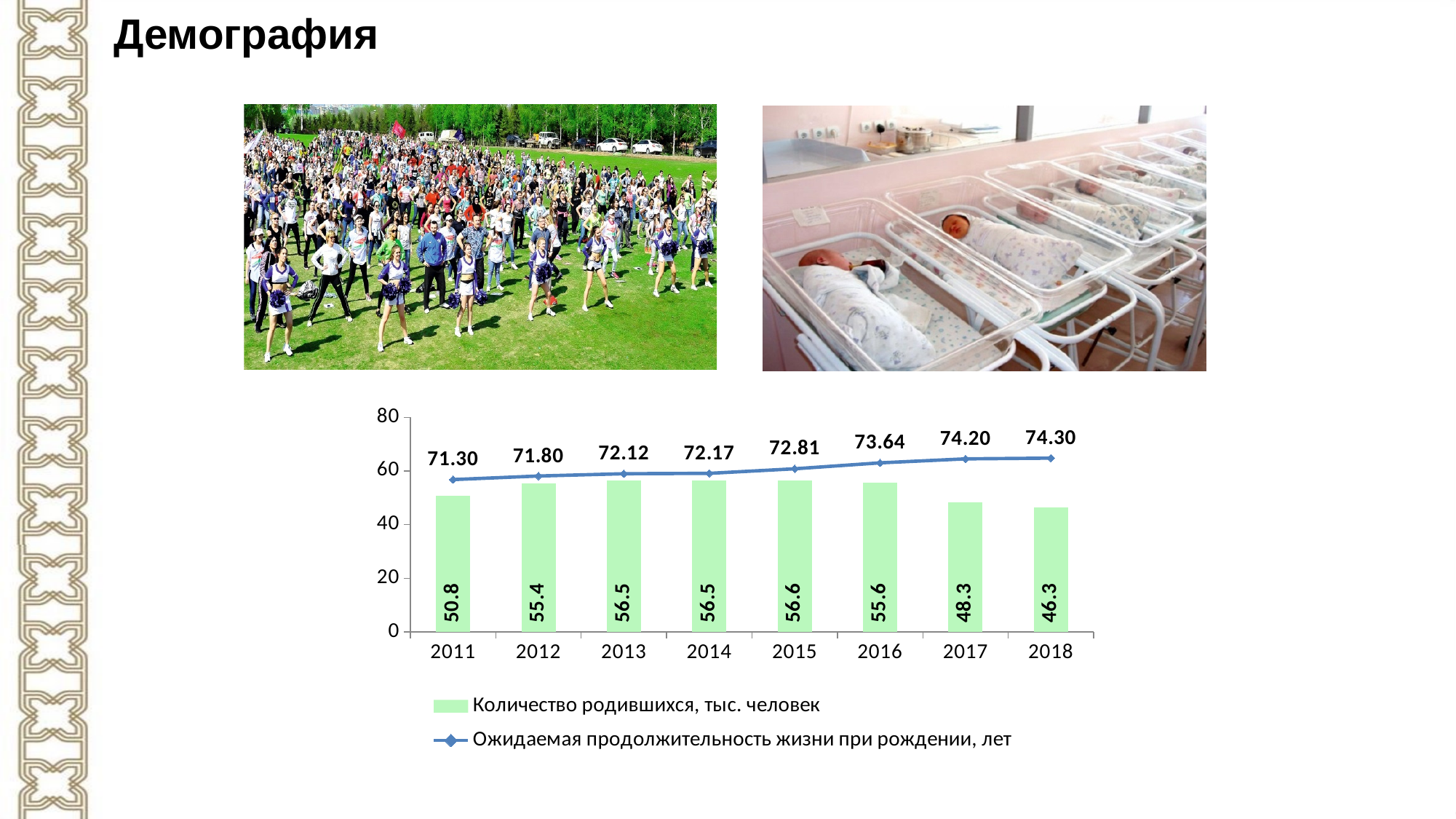
What is the difference between the number of births in 2016 and in 2017? 7.3 What is the number of births (Количество родившихся, тыс. человек) shown for 2015? 56.6 Does the life expectancy at birth rise or fall from 2011 to 2018? rises How many series does the chart legend list? 2 What is the expected life expectancy at birth (Ожидаемая продолжительность жизни при рождении, лет) shown for 2018? 74.30 What colour are the bars for the number of births in the chart? light green What is the number of births shown for 2011? 50.8 Which year has the lowest number of births (Количество родившихся)? 2018 Which year has the larger number of births, 2012 or 2017? 2012 Which year has the highest life expectancy at birth? 2018 What is the life expectancy at birth shown for 2013? 72.12 How many years are shown on the x axis of the chart? 8